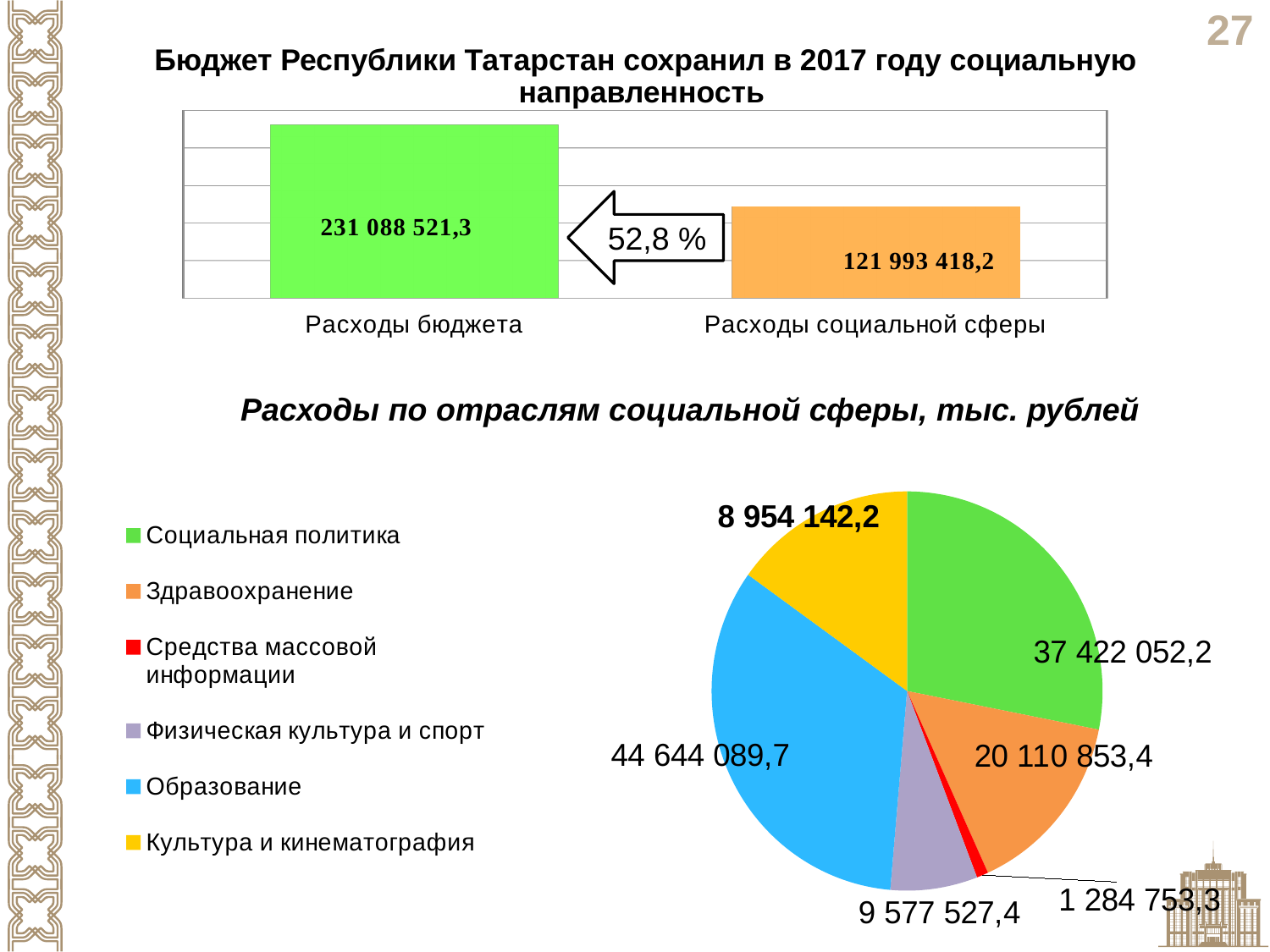
What percentage is shown in the arrow between the two bars of the top chart? 52,8 % In the pie chart 'Расходы по отраслям социальной сферы', what is the value for Образование? 44 644 089,7 What kind of chart is the top chart on the slide? bar chart In the top bar chart, what is the difference between Расходы бюджета and Расходы социальной сферы? 109 095 103,1 In the pie chart 'Расходы по отраслям социальной сферы', which category has the smallest value? Средства массовой информации In the pie chart 'Расходы по отраслям социальной сферы', what is the value for Здравоохранение? 20 110 853,4 In the top bar chart, what is the value for Расходы социальной сферы? 121 993 418,2 In the pie chart 'Расходы по отраслям социальной сферы', how many categories does the legend list? 6 In the top bar chart, what is the value for Расходы бюджета? 231 088 521,3 In the pie chart 'Расходы по отраслям социальной сферы', which category has the largest value? Образование In the pie chart 'Расходы по отраслям социальной сферы', what is the difference between Образование and Социальная политика? 7 222 037,5